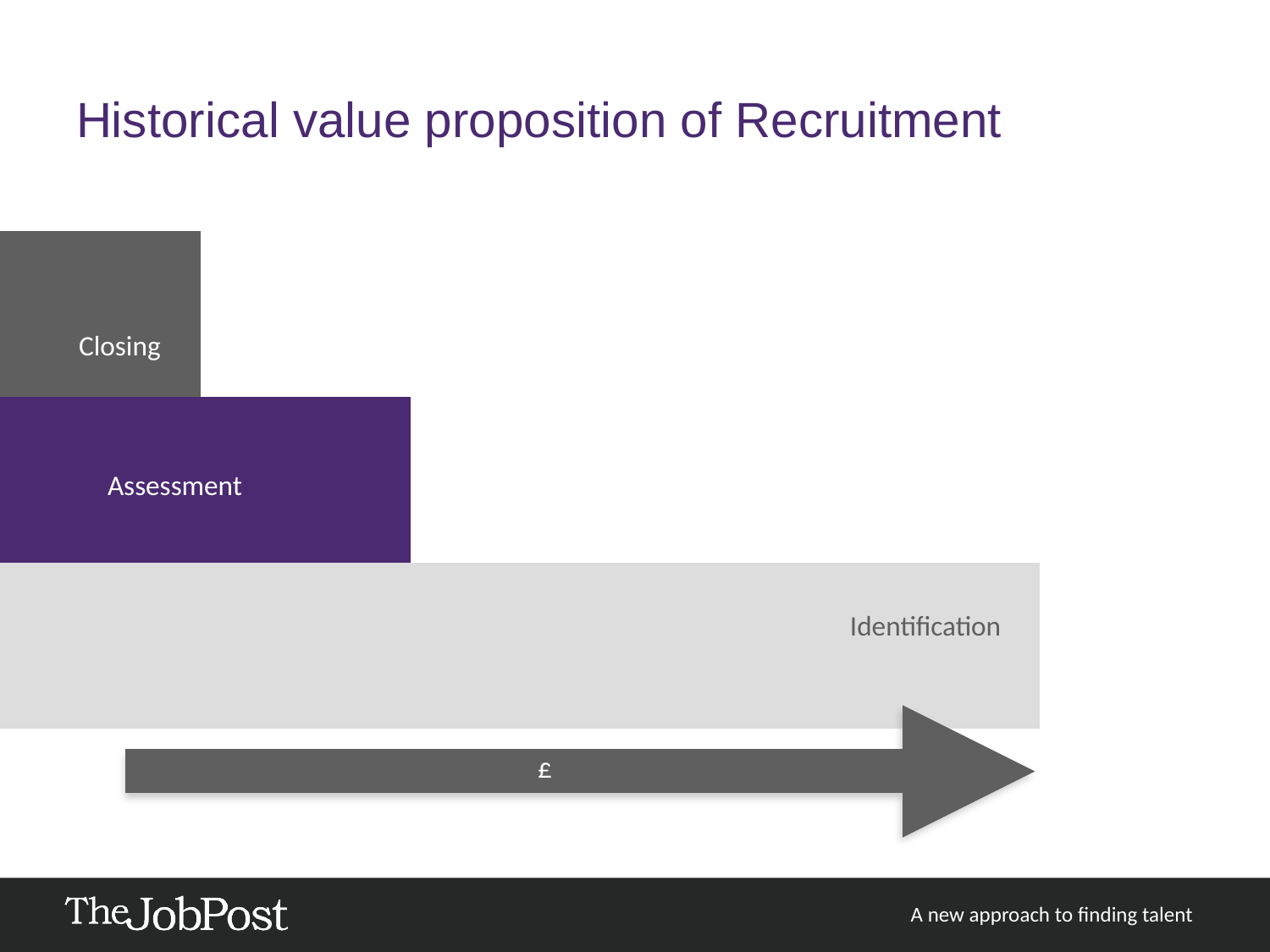
Reading from top to bottom, do the bars get longer or shorter? longer What symbol is printed on the arrow beneath the bars? £ Which bar is longer, Assessment or Closing? Assessment Which bar is longer, Identification or Assessment? Identification What is the title of the slide? Historical value proposition of Recruitment Which bar is the longest? Identification How many labelled bars are shown in the diagram? 3 Which bar is the shortest? Closing Which bar is coloured purple? Assessment